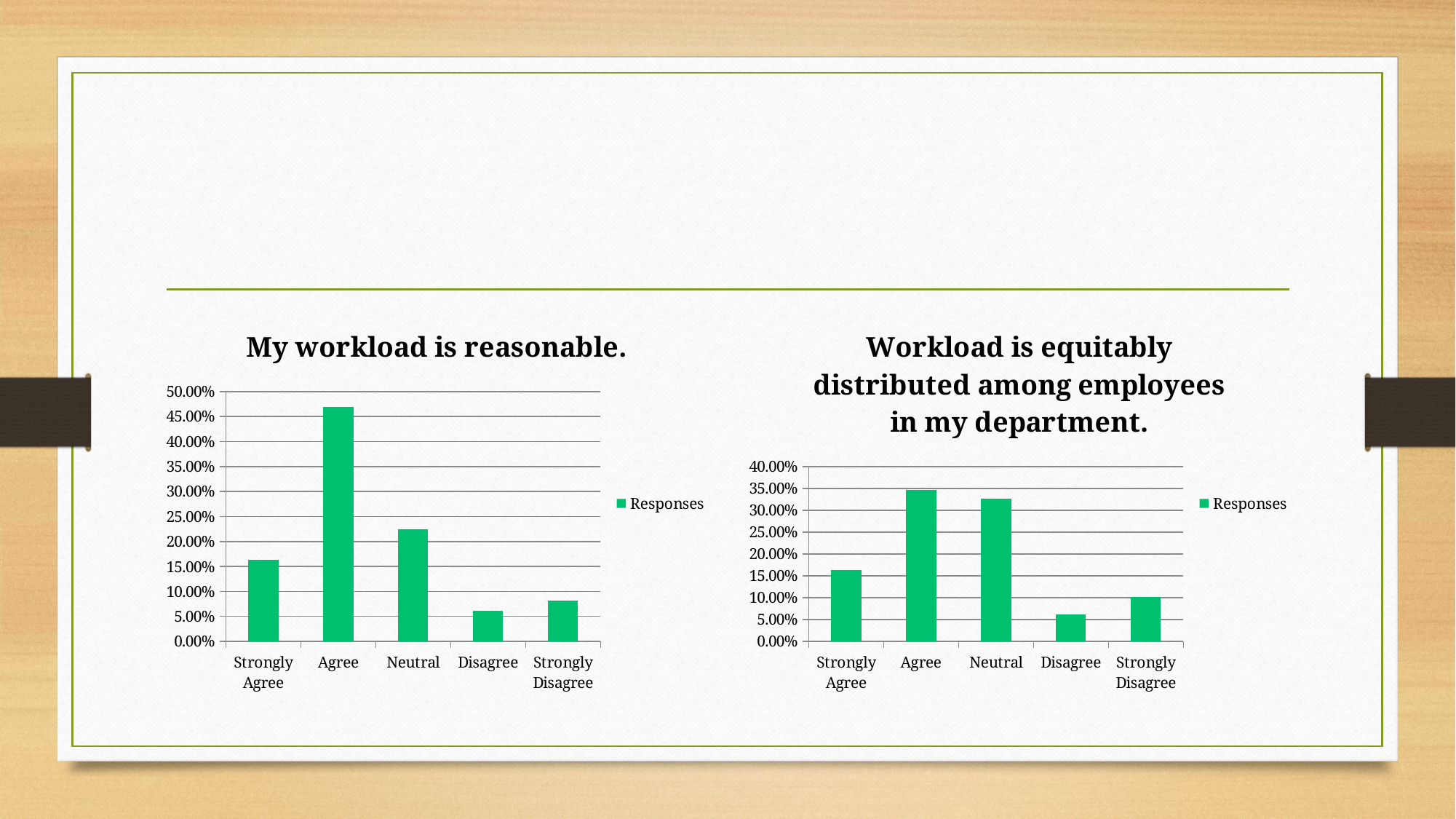
In the chart "My workload is reasonable.", is the value for Neutral greater or less than 25.00%? less In the chart "Workload is equitably distributed among employees in my department.", is the value for Neutral greater or less than 30.00%? greater In the chart "My workload is reasonable.", is the value for Agree greater or less than 45.00%? greater What type of chart is "My workload is reasonable."? bar chart In the chart "Workload is equitably distributed among employees in my department.", which response category has the lowest value? Disagree In the chart "Workload is equitably distributed among employees in my department.", which is larger, the value for Agree or the value for Strongly Disagree? Agree How many series does the legend list in the chart "Workload is equitably distributed among employees in my department."? 1 How many response categories are shown on the x axis of the chart "My workload is reasonable."? 5 In the chart "My workload is reasonable.", which response category has the lowest value? Disagree In the chart "My workload is reasonable.", which response category has the highest value? Agree In the chart "My workload is reasonable.", which is larger, the value for Strongly Agree or the value for Strongly Disagree? Strongly Agree